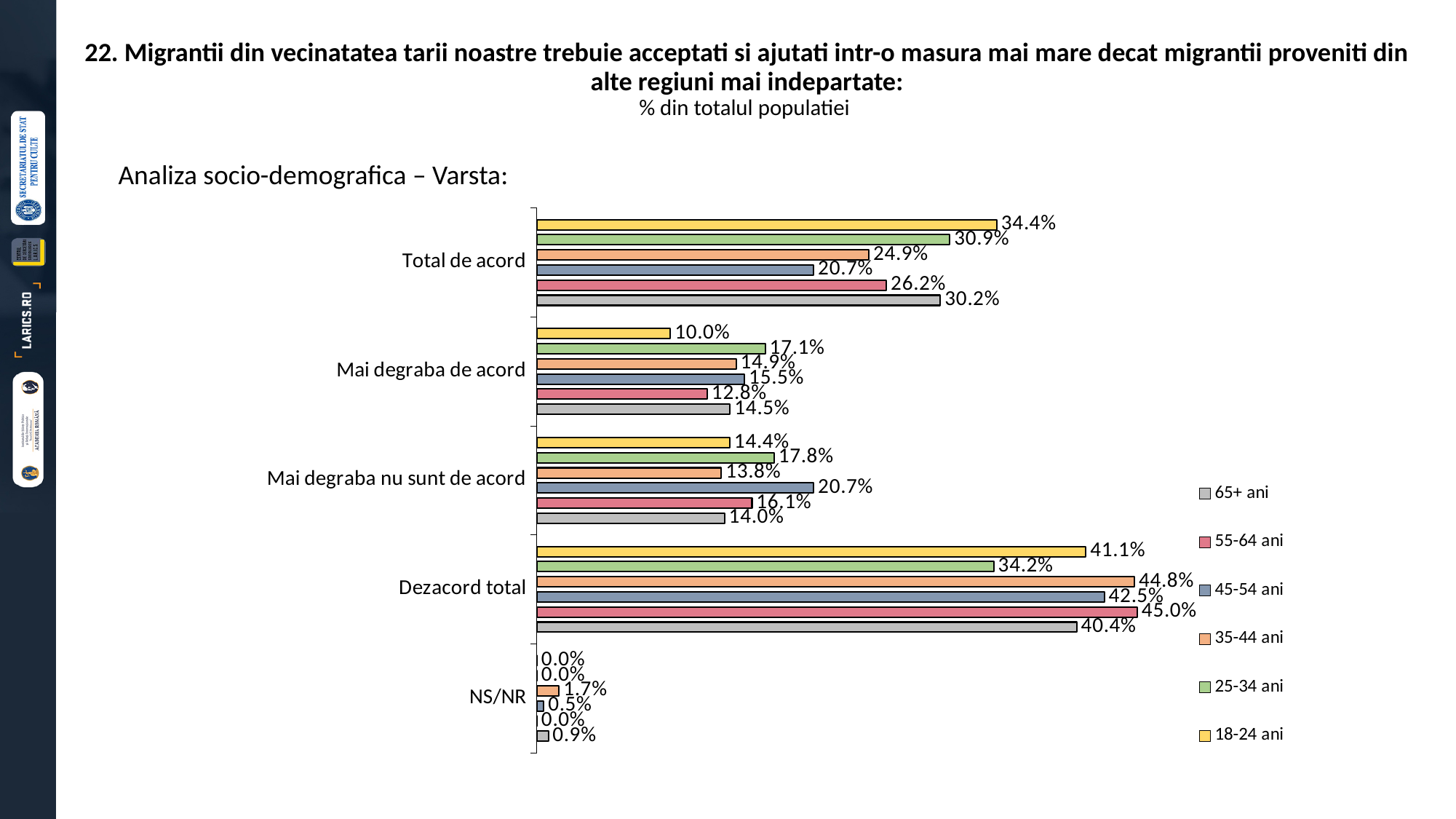
What is the difference between the 18-24 ani and 45-54 ani values in the Total de acord category? 13.7% Which legend entry is shown in yellow? 18-24 ani What is the value for 18-24 ani in the Total de acord category? 34.4% In the Mai degraba nu sunt de acord category, which is larger: the value for 45-54 ani or the value for 25-34 ani? 45-54 ani What is the value for 65+ ani in the Mai degraba nu sunt de acord category? 14.0% What is the value for 45-54 ani in the Dezacord total category? 42.5% What kind of chart is shown on the slide? bar chart How many series does the legend list? 6 Which age group has the highest value in the Dezacord total category? 55-64 ani How many response categories are shown on the chart? 5 What is the value for 35-44 ani in the NS/NR category? 1.7% Which age group has the lowest value in the Mai degraba de acord category? 18-24 ani